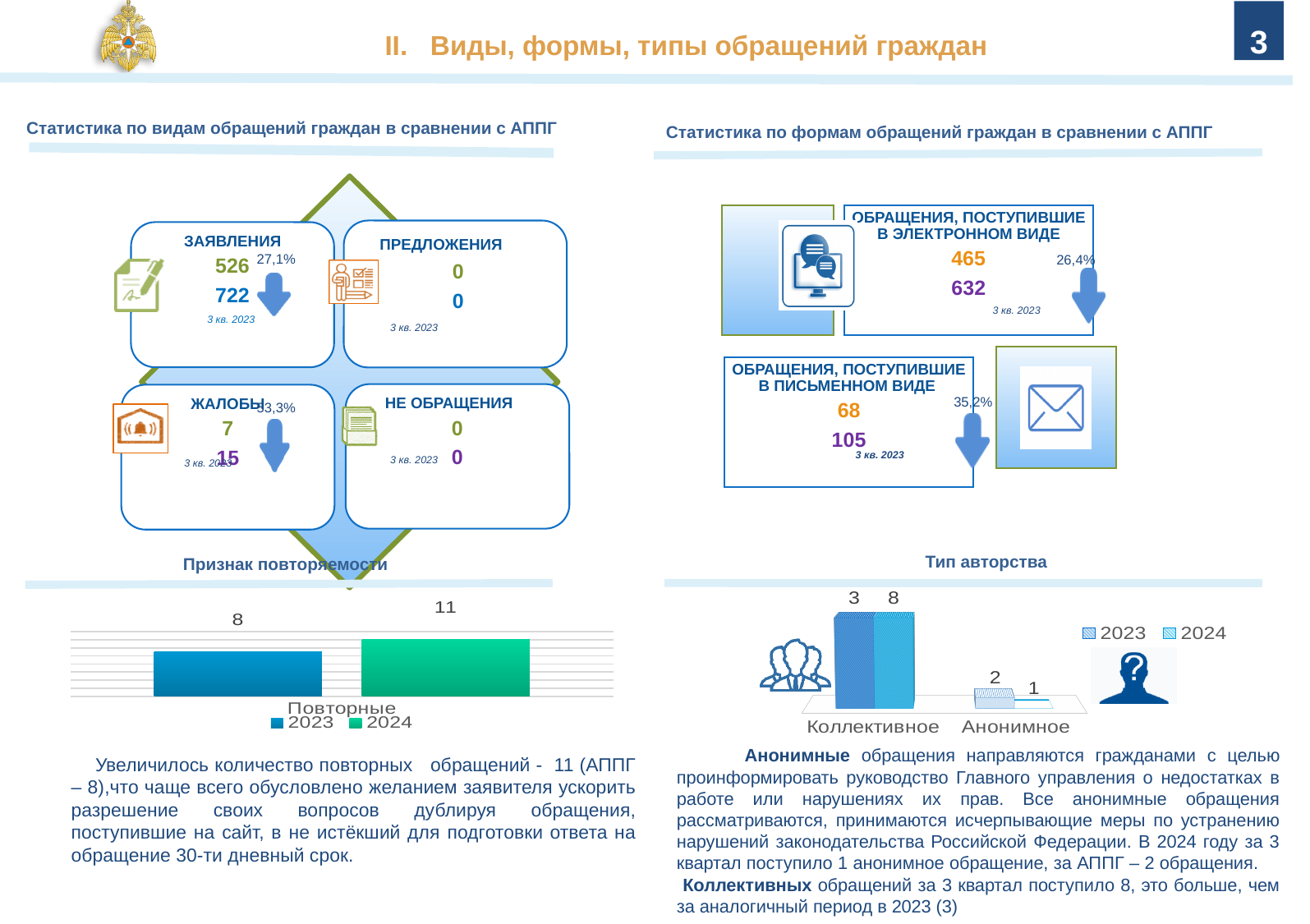
In the 'Тип авторства' chart, what is the 2024 value for Коллективное? 8 In the 'Признак повторяемости' chart, what is the value for 2024? 11 In the 'Тип авторства' chart, which category has the lowest 2024 value? Анонимное In the 'Признак повторяемости' chart, what is the difference between the 2024 and 2023 values? 3 In the 'Признак повторяемости' chart, how many series does the legend list? 2 In the 'Признак повторяемости' chart, which year has the larger value, 2023 or 2024? 2024 In the 'Признак повторяемости' chart, what is the value for 2023? 8 What kind of chart is the 'Признак повторяемости' chart? bar chart In the 'Тип авторства' chart, how many categories are shown on the x axis? 2 In the 'Тип авторства' chart, which is larger: the 2023 value for Анонимное or the 2024 value for Анонимное? 2023 In the 'Тип авторства' chart, what is the difference between the 2024 and 2023 values for Коллективное? 5 In the 'Тип авторства' chart, what is the 2023 value for Анонимное? 2